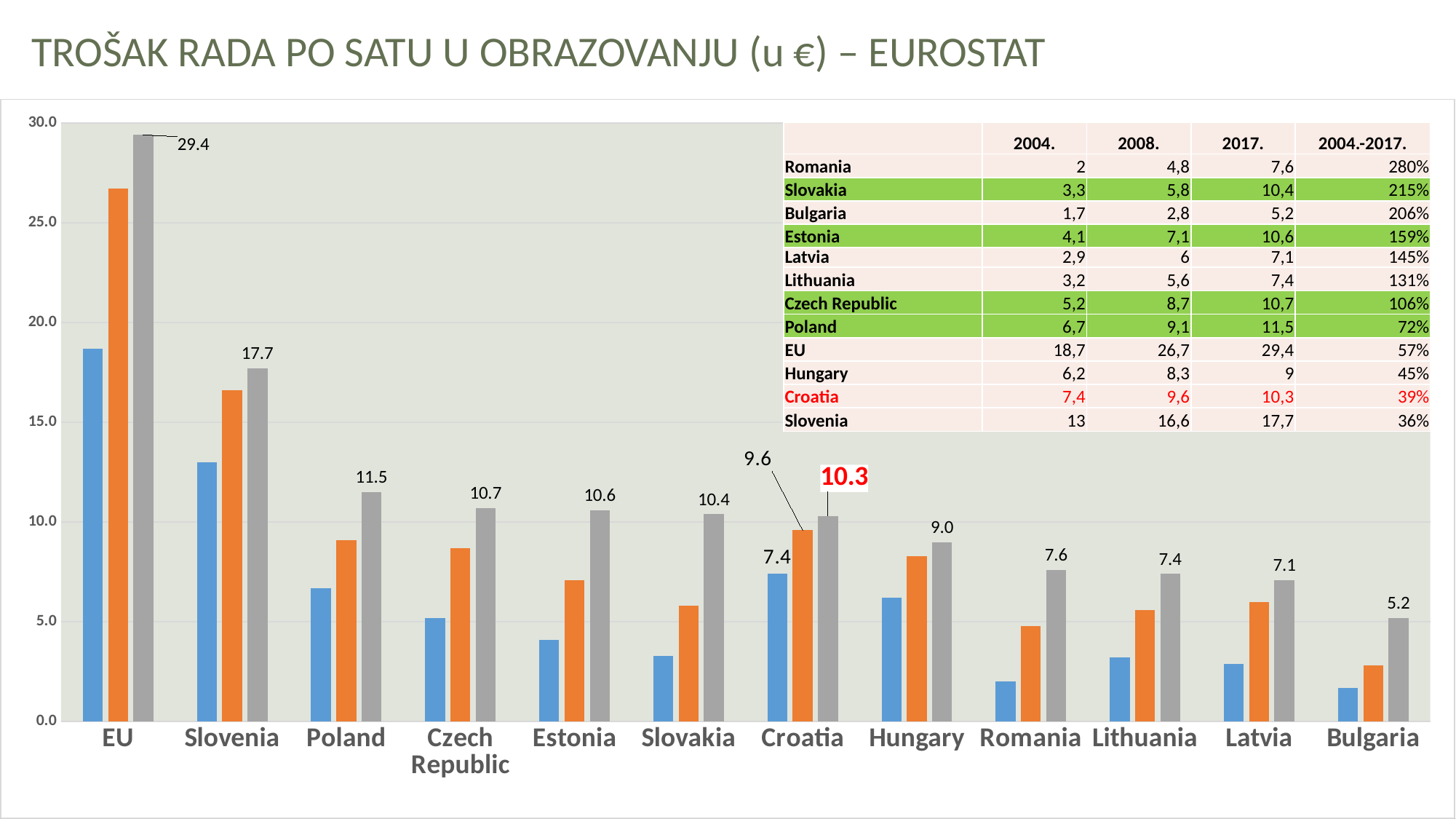
What value is labelled above the bars for Slovenia? 17.7 Which category has the highest labelled value on the chart? EU What value is shown in red above the bars for Croatia? 10.3 How many categories are shown on the x axis of the chart? 12 Is the value of the blue bar for Latvia greater or less than 5.0? less What kind of chart is shown on the slide? bar chart Which has the larger labelled value, Estonia or Slovakia? Estonia What value is labelled above the bars for Bulgaria? 5.2 What is the difference between the labelled values for Poland (11.5) and Czech Republic (10.7)? 0.8 What is the difference between the two labelled values for Croatia, 10.3 and 7.4? 2.9 What value is labelled above the tallest bar for EU? 29.4 Which category has the lowest labelled value on the chart? Bulgaria